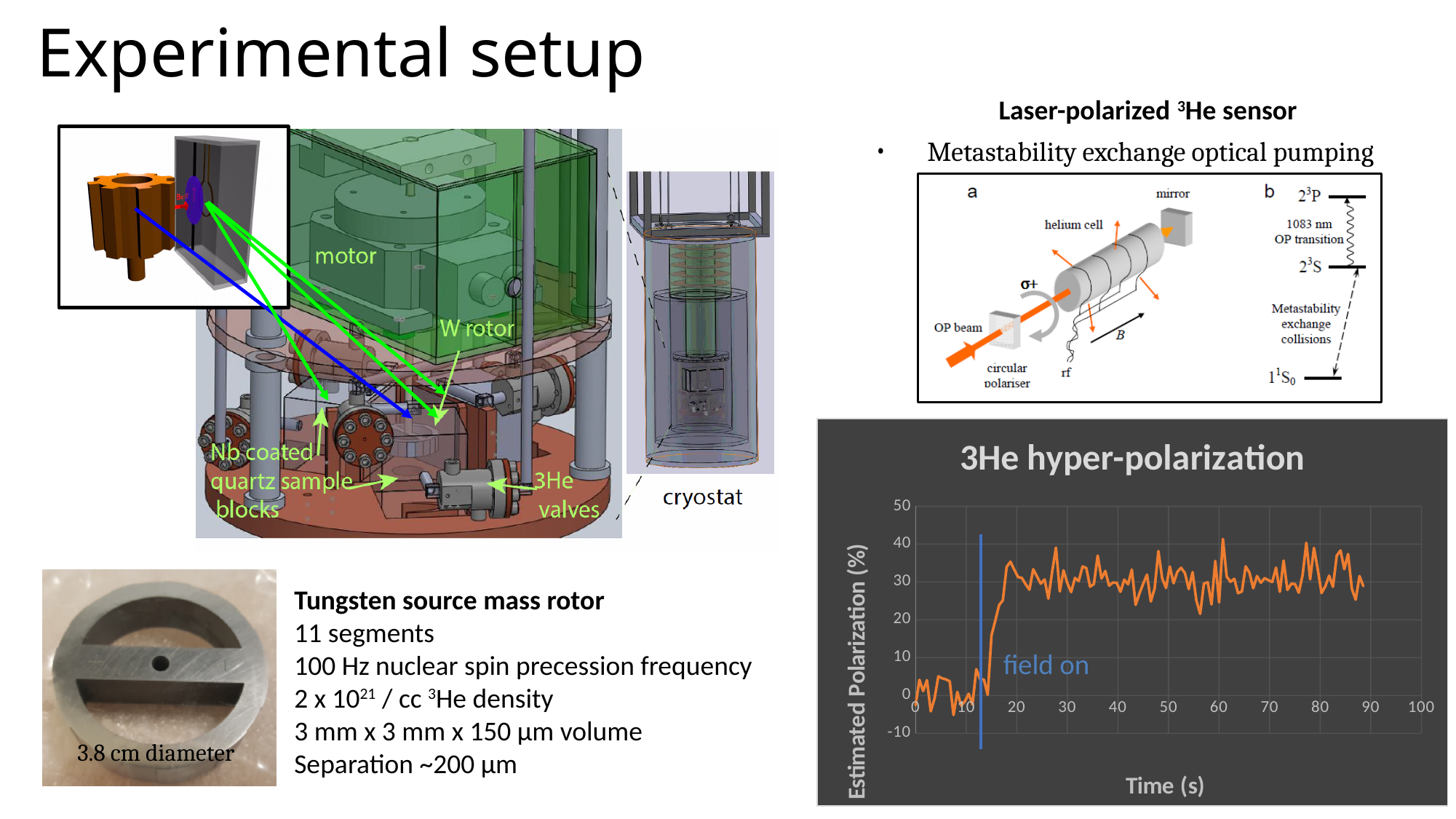
In the "3He hyper-polarization" chart, what is the label of the y axis? Estimated Polarization (%) In the "3He hyper-polarization" chart, is the estimated polarization at a time of 60 s greater or less than 20? greater In the "3He hyper-polarization" chart, is the estimated polarization higher before or after the "field on" marker? after In the "3He hyper-polarization" chart, does the estimated polarization rise or fall when the field is turned on? rise What kind of chart is the "3He hyper-polarization" chart? line chart What is the title of the chart on the dark panel at the lower right of the slide? 3He hyper-polarization In the "3He hyper-polarization" chart, is the estimated polarization at a time of 80 s greater or less than 50? less In the "3He hyper-polarization" chart, is the estimated polarization at a time of 40 s greater or less than 20? greater In the "3He hyper-polarization" chart, what is the highest value shown on the y axis? 50